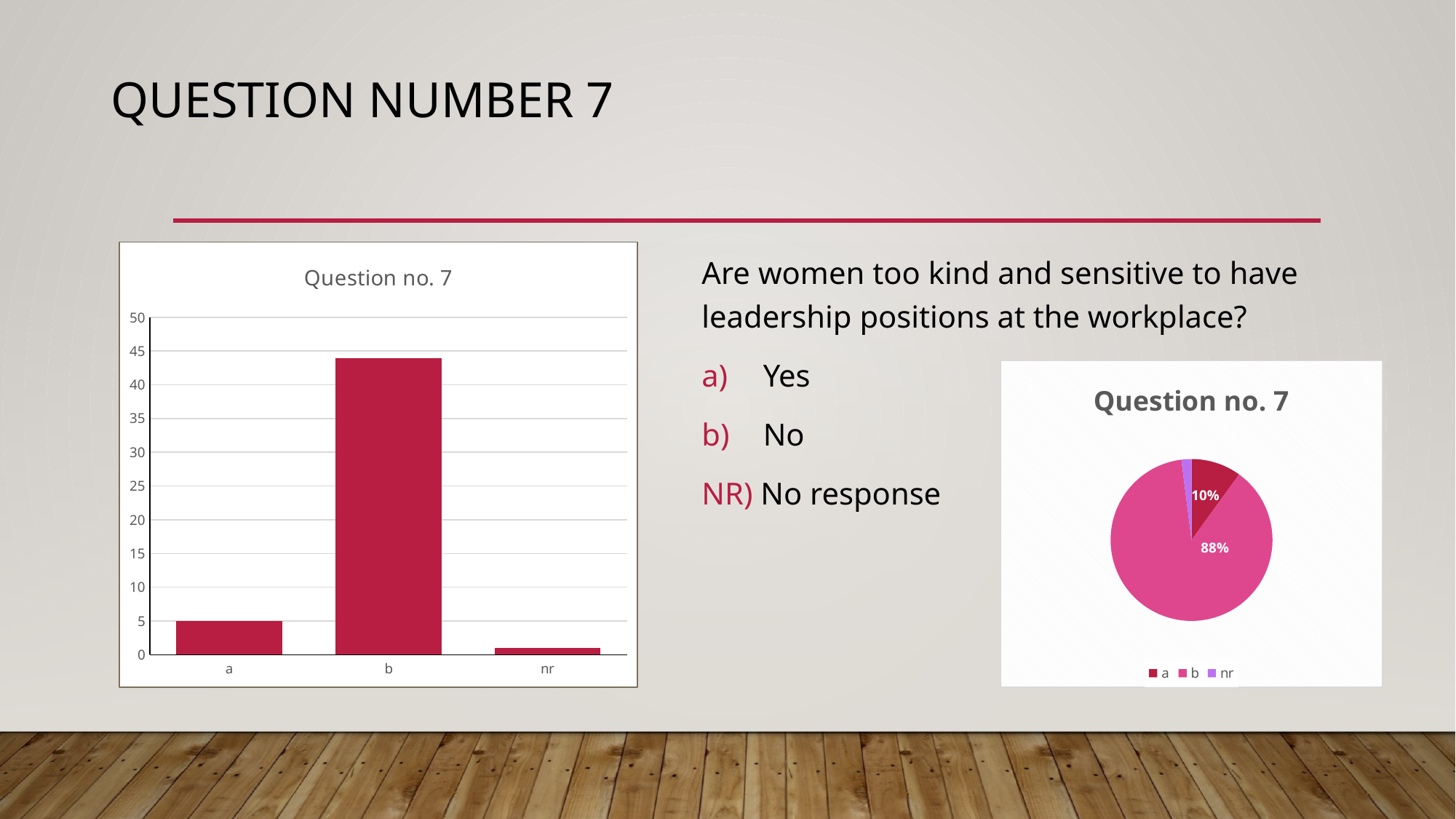
What kind of chart is the chart on the left of the slide? bar chart In the bar chart on the left, which is larger, the value for a or the value for nr? a How many entries does the legend of the pie chart on the right list? 3 In the pie chart on the right, what share of the pie does slice b take? 88% In the bar chart on the left, is the value for nr greater or less than 5? less In the bar chart on the left, which category has the highest bar? b What kind of chart is the chart on the right of the slide? pie chart In the pie chart on the right, what share of the pie does slice a take? 10% In the bar chart on the left, what is the value for category a? 5 In the bar chart on the left, is the value for b greater or less than 40? greater In the bar chart on the left, how many categories are shown on the x axis? 3 In the bar chart on the left, which category has the lowest bar? nr